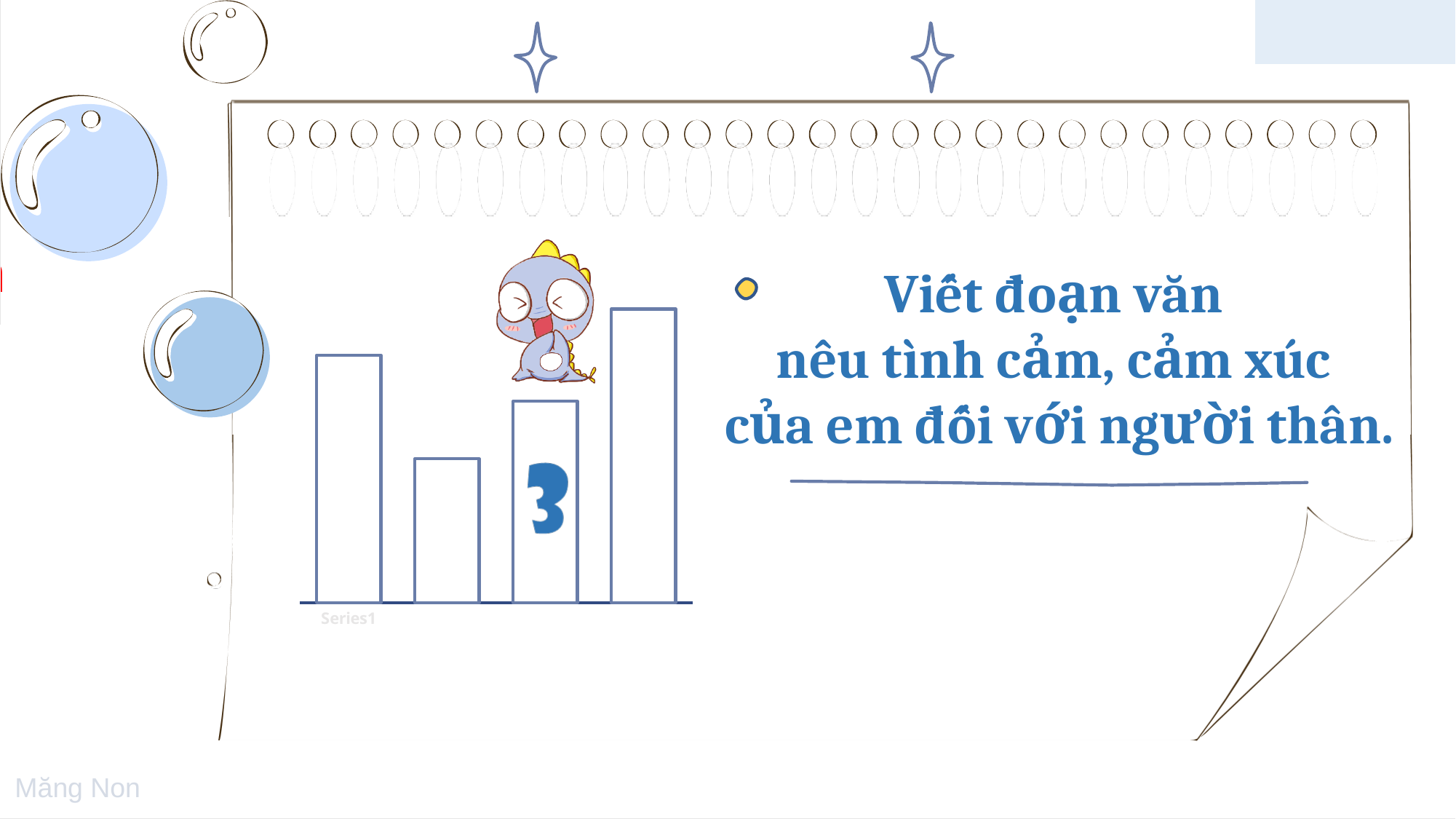
What label is printed below the axis of the chart? Series1 What kind of chart is shown on the slide? bar chart Which is taller in the chart: the first bar or the third bar? the first bar Which is taller in the chart: the first bar or the second bar? the first bar Do the bar heights in the chart rise steadily from left to right? no Which is taller in the chart: the third bar or the fourth bar? the fourth bar Are the bars in the chart vertical or horizontal? vertical Which bar in the chart is the shortest, counting from the left? the second bar How many bars does the chart on the slide have? 4 Which bar in the chart is the tallest, counting from the left? the fourth (rightmost) bar